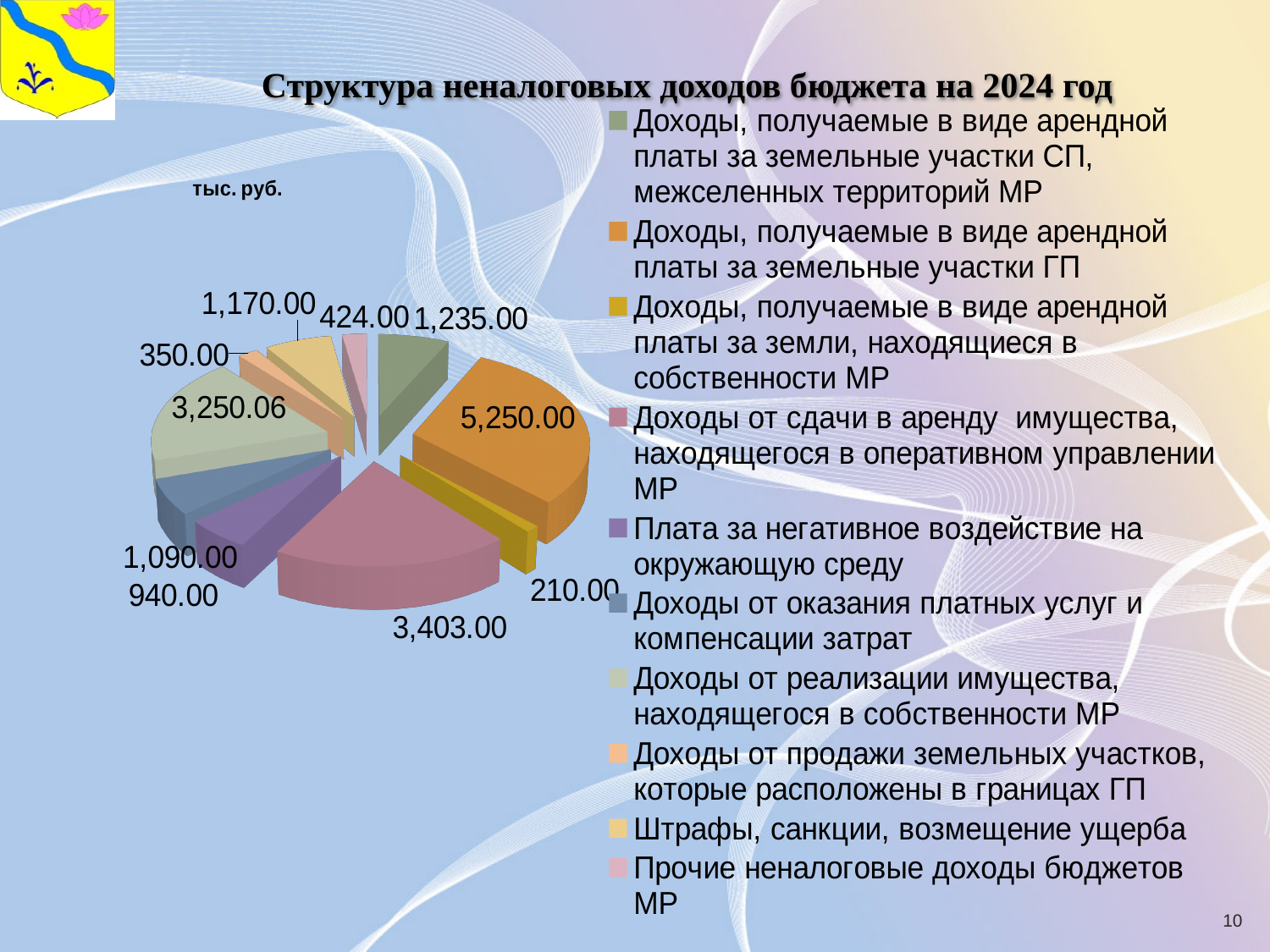
What is the value for 'Штрафы, санкции, возмещение ущерба'? 1,170.00 Which is larger: the value for 'Плата за негативное воздействие на окружающую среду' or the value for 'Доходы от оказания платных услуг и компенсации затрат'? Доходы от оказания платных услуг и компенсации затрат What is the value for 'Доходы, получаемые в виде арендной платы за земельные участки ГП'? 5,250.00 What is the value for 'Доходы от реализации имущества, находящегося в собственности МР'? 3,250.06 What is the value for 'Доходы от сдачи в аренду имущества, находящегося в оперативном управлении МР'? 3,403.00 What is the difference between the value for 'Доходы, получаемые в виде арендной платы за земельные участки ГП' and the value for 'Доходы от сдачи в аренду имущества, находящегося в оперативном управлении МР'? 1,847.00 What is the title of the chart? Структура неналоговых доходов бюджета на 2024 год Which category has the smallest slice of the pie? Доходы, получаемые в виде арендной платы за земли, находящиеся в собственности МР How many slices does the pie chart have? 10 What kind of chart is shown on the slide? Pie chart How many entries does the legend list? 10 Which category has the largest slice of the pie? Доходы, получаемые в виде арендной платы за земельные участки ГП